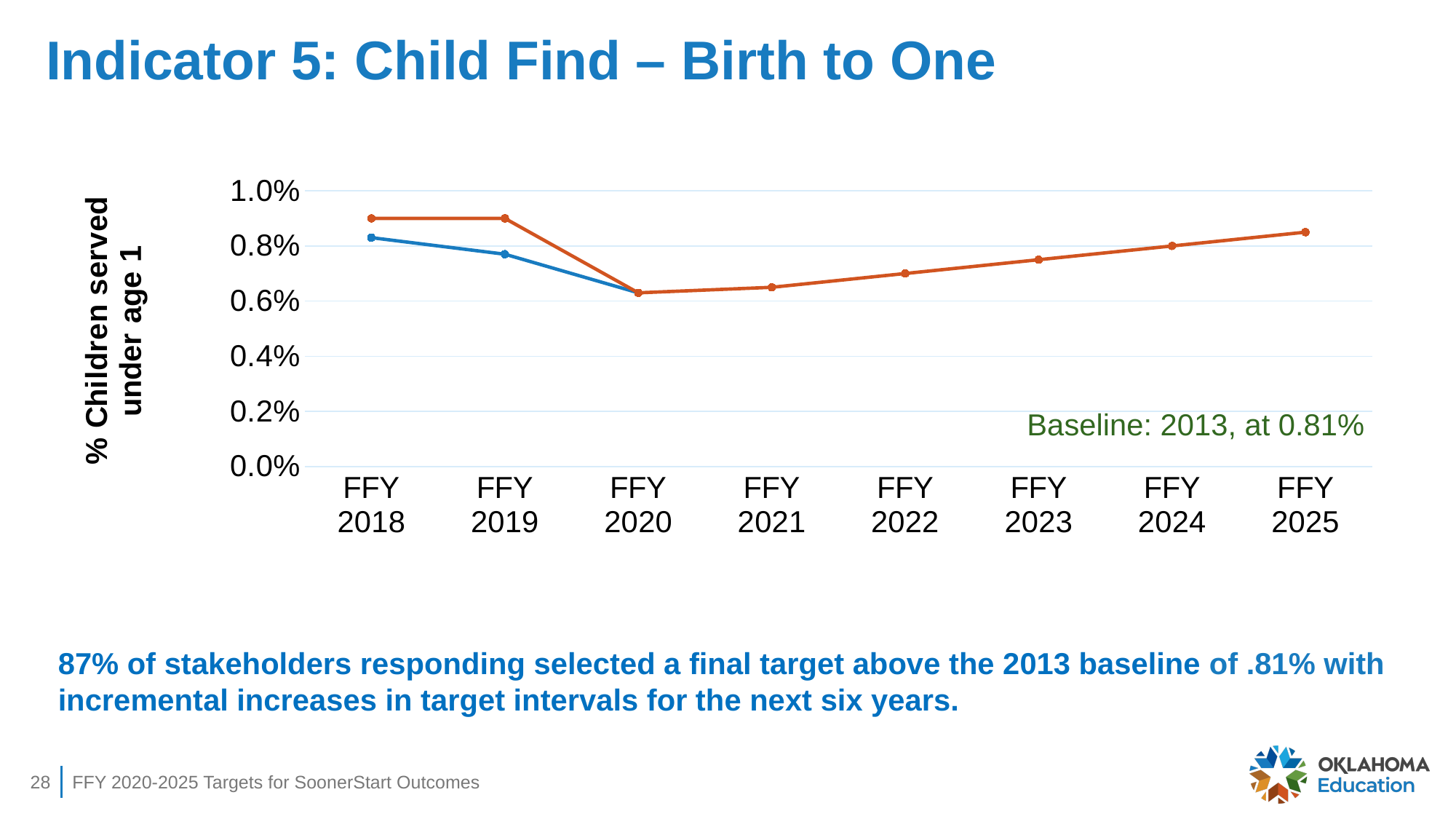
In which FFY does the orange line reach its lowest value? FFY 2020 Is the value of the orange line for FFY 2018 greater or less than 0.8%? greater Is the value of the orange line for FFY 2020 greater or less than 0.8%? less In FFY 2018, which line has the higher value, the orange line or the blue line? orange line Is the value of the orange line for FFY 2022 greater or less than 0.6%? greater Does the orange line rise or fall from FFY 2020 to FFY 2025? rise What is the y-axis title of the chart? % Children served under age 1 How many lines are plotted on the chart? 2 How many FFY categories are shown on the x axis? 8 What kind of chart is shown on the slide? line chart What baseline value is annotated on the chart? Baseline: 2013, at 0.81%